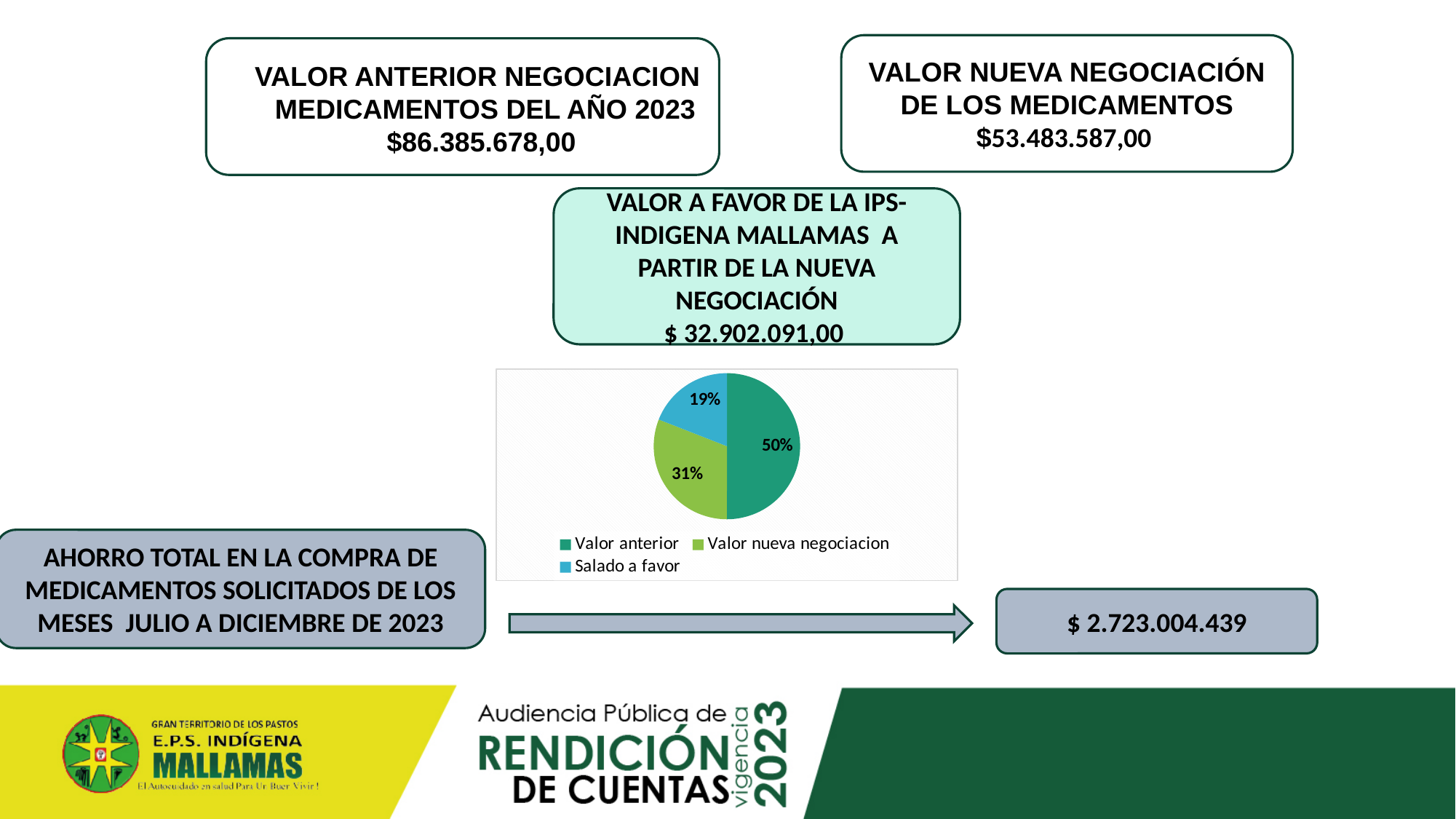
What share of the pie does "Valor anterior" represent? 50% How many entries does the legend of the pie chart list? 3 What share of the pie does "Salado a favor" represent? 19% Which is larger in the pie chart, "Valor nueva negociacion" or "Salado a favor"? Valor nueva negociacion How many slices does the pie chart have? 3 What is the difference in percentage points between the "Valor anterior" slice and the "Valor nueva negociacion" slice? 19 What share of the pie does "Valor nueva negociacion" represent? 31% What kind of chart is shown on the slide? pie chart What colour is the "Salado a favor" slice in the pie chart? light blue What colour is the "Valor anterior" slice in the pie chart? green (teal green) Which slice of the pie chart is the largest? Valor anterior Which slice of the pie chart is the smallest? Salado a favor